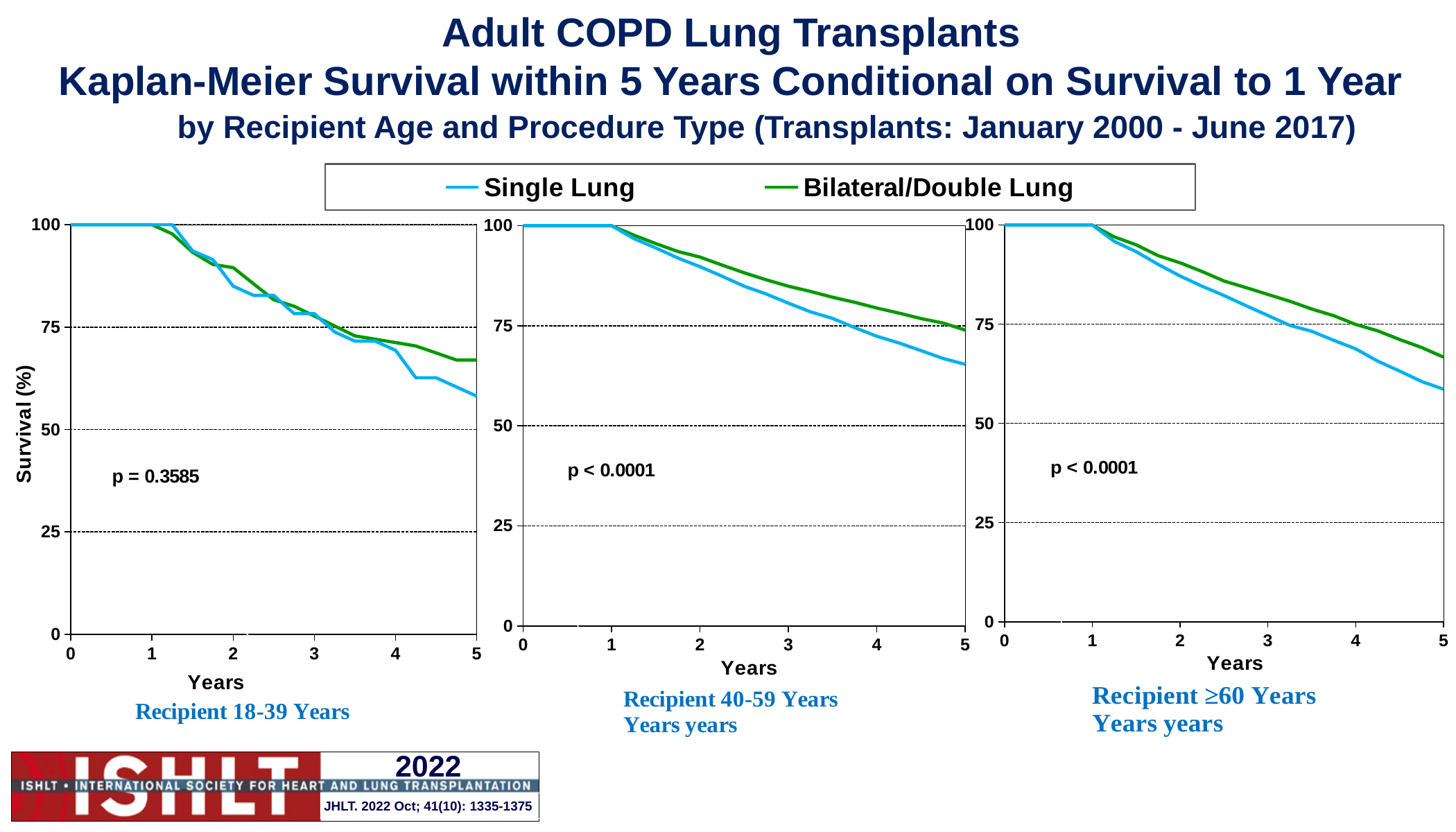
How many separate survival charts are shown on the slide? 3 Which colour represents Single Lung in the legend? blue In the 'Recipient ≥60 Years' chart, is the Bilateral/Double Lung survival at 5 years greater or less than 75? less In the 'Recipient 18-39 Years' chart, is the Single Lung survival at 5 years greater or less than 75? less In the 'Recipient 40-59 Years' chart, which series has higher survival at 5 years, Single Lung or Bilateral/Double Lung? Bilateral/Double Lung In the 'Recipient ≥60 Years' chart, which series has higher survival at 5 years, Single Lung or Bilateral/Double Lung? Bilateral/Double Lung How many series does the legend list? 2 In the 'Recipient ≥60 Years' chart, does Single Lung survival rise or fall from year 1 to year 5? fall In the 'Recipient 40-59 Years' chart, is the Single Lung survival at 5 years greater or less than 75? less What p-value is printed on the 'Recipient 18-39 Years' chart? p = 0.3585 What kind of chart is used in the 'Recipient 18-39 Years' panel? line chart